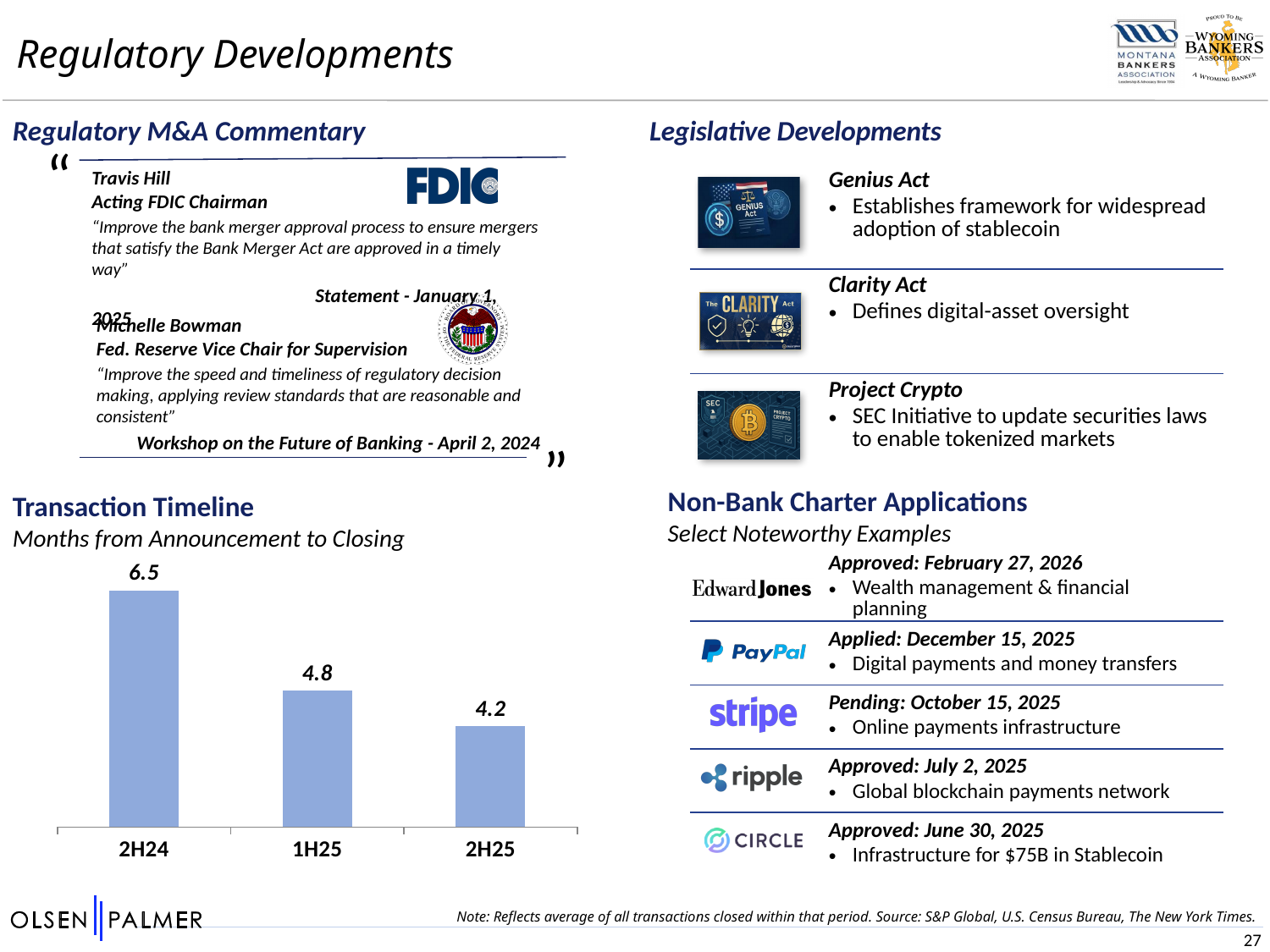
In the Transaction Timeline chart, do the values rise or fall from 2H24 to 2H25? Fall In the Transaction Timeline chart, which period has the lowest value? 2H25 In the Transaction Timeline chart, what is the difference between the values for 2H24 and 2H25? 2.3 In the Transaction Timeline chart, what is the difference between the values for 1H25 and 2H25? 0.6 In the Transaction Timeline chart, which period has the highest value? 2H24 What is the subtitle of the Transaction Timeline chart? Months from Announcement to Closing In the Transaction Timeline chart, which is larger, the value for 1H25 or the value for 2H25? 1H25 In the Transaction Timeline chart, what is the value for 1H25? 4.8 How many periods are shown in the Transaction Timeline chart? 3 In the Transaction Timeline chart, what is the value for 2H25? 4.2 In the Transaction Timeline chart, what is the value for 2H24? 6.5 What kind of chart is the Transaction Timeline chart? Bar chart